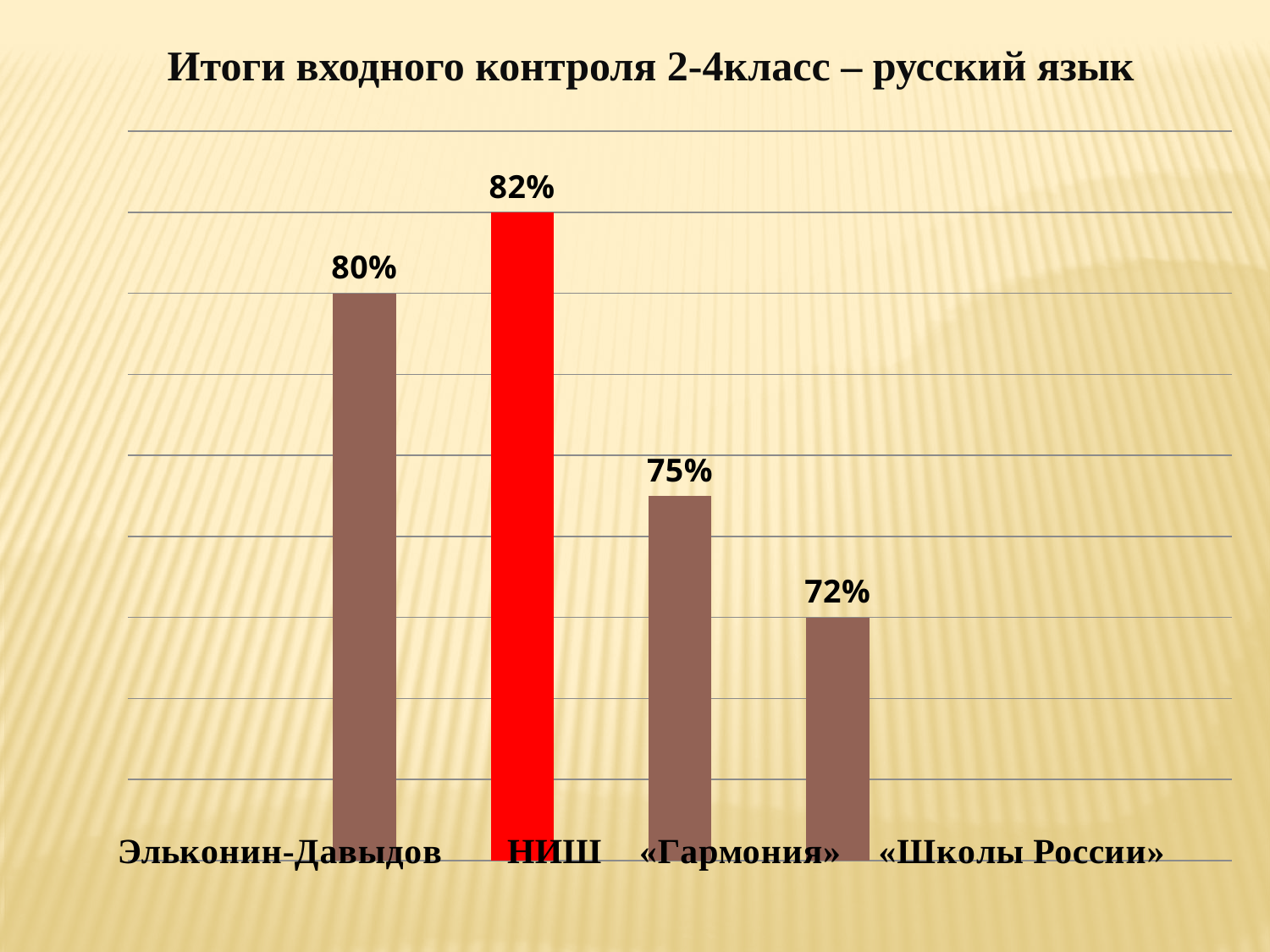
Which category has the lowest value? «Школы России» Which bar is coloured red? НИШ What kind of chart is shown on the slide? Bar chart What is the difference between the values for НИШ and «Школы России»? 10% What is the value for Эльконин-Давыдов? 80% What is the value for «Школы России»? 72% What is the value for НИШ? 82% Which category has the highest value? НИШ What is the value for «Гармония»? 75% What is the difference between the values for Эльконин-Давыдов and «Гармония»? 5% How many categories are shown in the chart? 4 Which is larger, the value for «Гармония» or the value for «Школы России»? «Гармония»